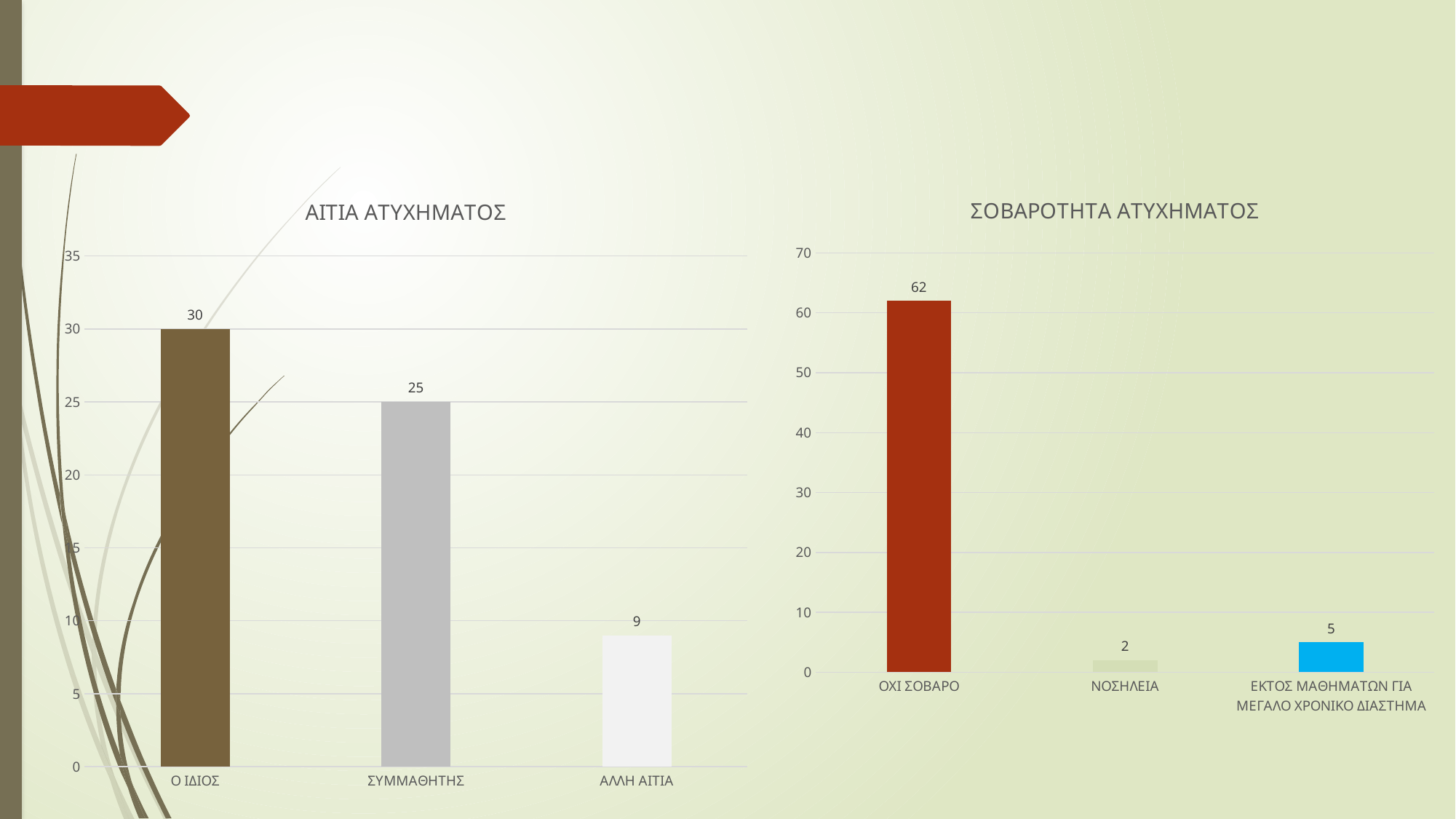
In the chart titled ΑΙΤΙΑ ΑΤΥΧΗΜΑΤΟΣ, what is the value for Ο ΙΔΙΟΣ? 30 What is the title of the chart on the left side of the slide? ΑΙΤΙΑ ΑΤΥΧΗΜΑΤΟΣ In the chart titled ΣΟΒΑΡΟΤΗΤΑ ΑΤΥΧΗΜΑΤΟΣ, what is the value for ΟΧΙ ΣΟΒΑΡΟ? 62 In the chart titled ΣΟΒΑΡΟΤΗΤΑ ΑΤΥΧΗΜΑΤΟΣ, which is larger: the value for ΝΟΣΗΛΕΙΑ or the value for ΕΚΤΟΣ ΜΑΘΗΜΑΤΩΝ ΓΙΑ ΜΕΓΑΛΟ ΧΡΟΝΙΚΟ ΔΙΑΣΤΗΜΑ? ΕΚΤΟΣ ΜΑΘΗΜΑΤΩΝ ΓΙΑ ΜΕΓΑΛΟ ΧΡΟΝΙΚΟ ΔΙΑΣΤΗΜΑ In the chart titled ΑΙΤΙΑ ΑΤΥΧΗΜΑΤΟΣ, what is the value for ΑΛΛΗ ΑΙΤΙΑ? 9 In the chart titled ΣΟΒΑΡΟΤΗΤΑ ΑΤΥΧΗΜΑΤΟΣ, what is the value for ΝΟΣΗΛΕΙΑ? 2 In the chart titled ΣΟΒΑΡΟΤΗΤΑ ΑΤΥΧΗΜΑΤΟΣ, what is the difference between the values for ΟΧΙ ΣΟΒΑΡΟ and ΕΚΤΟΣ ΜΑΘΗΜΑΤΩΝ ΓΙΑ ΜΕΓΑΛΟ ΧΡΟΝΙΚΟ ΔΙΑΣΤΗΜΑ? 57 In the chart titled ΑΙΤΙΑ ΑΤΥΧΗΜΑΤΟΣ, how many categories are shown? 3 In the chart titled ΑΙΤΙΑ ΑΤΥΧΗΜΑΤΟΣ, what is the difference between the values for Ο ΙΔΙΟΣ and ΣΥΜΜΑΘΗΤΗΣ? 5 In the chart titled ΣΟΒΑΡΟΤΗΤΑ ΑΤΥΧΗΜΑΤΟΣ, which category has the lowest value? ΝΟΣΗΛΕΙΑ In the chart titled ΑΙΤΙΑ ΑΤΥΧΗΜΑΤΟΣ, which category has the highest value? Ο ΙΔΙΟΣ What kind of chart is the chart titled ΣΟΒΑΡΟΤΗΤΑ ΑΤΥΧΗΜΑΤΟΣ? Bar chart